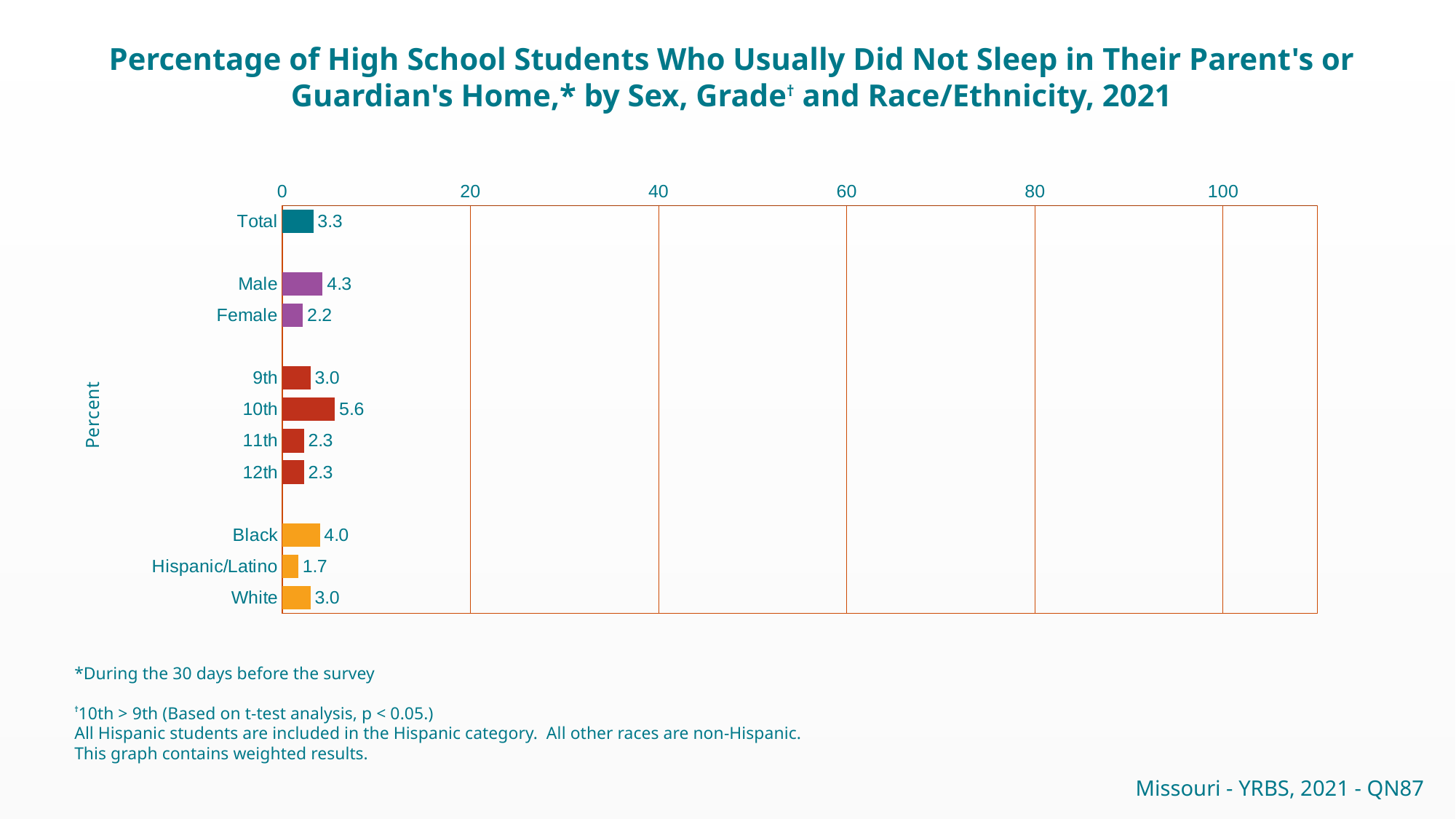
What kind of chart is shown on the slide? bar chart What is the value for 10th grade? 5.6 What is the value for Hispanic/Latino students? 1.7 What percentage of Male students usually did not sleep in their parent's or guardian's home? 4.3 Which category has the highest value on the chart? 10th What is the difference between the Male and Female values? 2.1 Which is larger, the value for Black or the value for White? Black What is the label on the vertical axis? Percent How many categories are plotted on the chart? 11 Which category has the lowest value on the chart? Hispanic/Latino What is the value for Total? 3.3 Is the value for 10th grade greater or less than 20? less